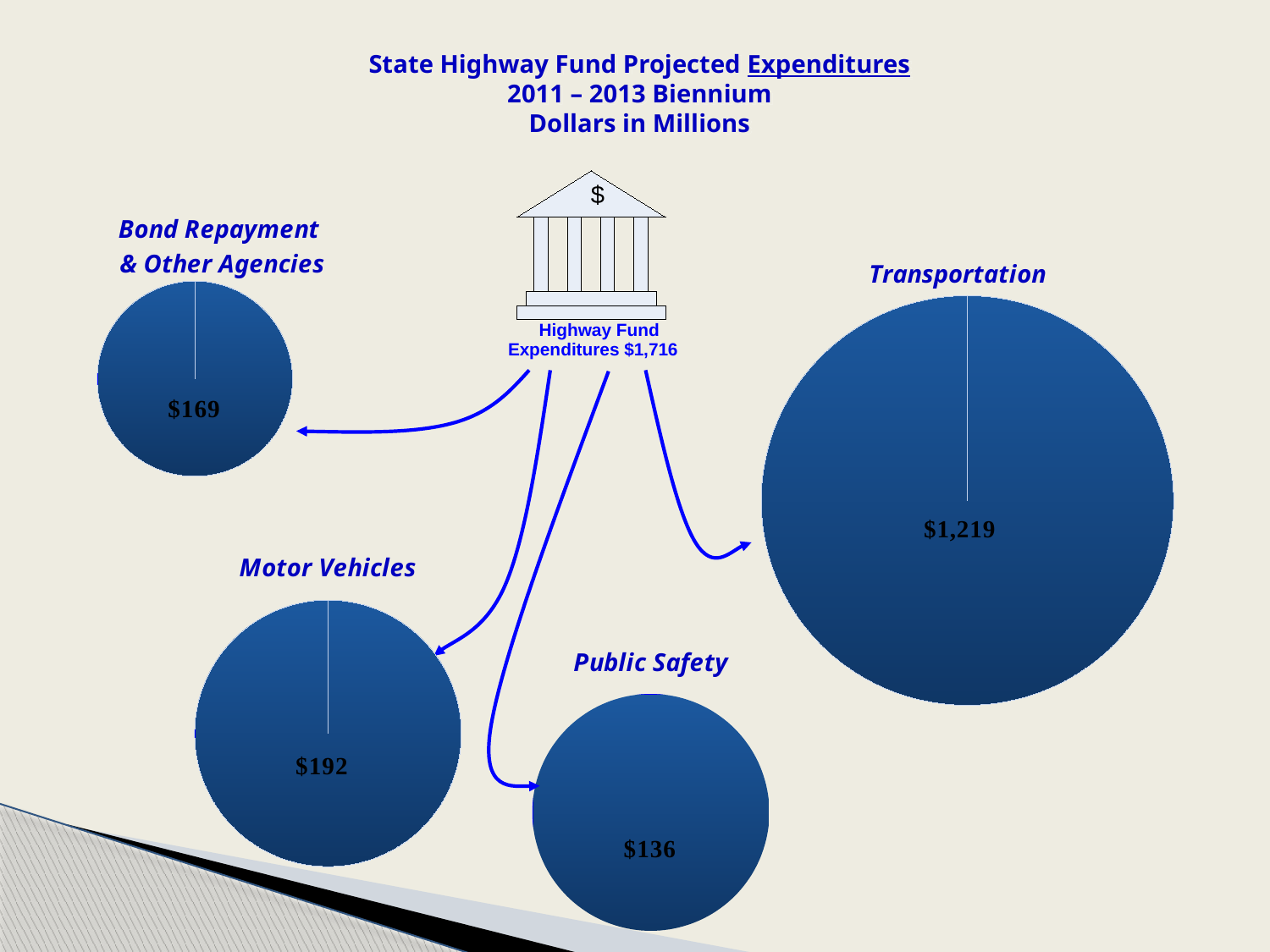
Which expenditure category has the largest value on the slide? Transportation Which is larger, the Motor Vehicles value or the Bond Repayment & Other Agencies value? Motor Vehicles What is the value shown in the Transportation circle? $1,219 What is the difference between the Transportation value and the Bond Repayment & Other Agencies value? $1,050 What is the value shown in the Motor Vehicles circle? $192 What is the difference between the Motor Vehicles value and the Public Safety value? $56 What is the total Highway Fund Expenditures figure shown on the slide? $1,716 How many expenditure categories are shown as circles on the slide? 4 Which expenditure category has the smallest value on the slide? Public Safety What is the value shown in the Bond Repayment & Other Agencies circle? $169 What is the value shown in the Public Safety circle? $136 In what units are the dollar values on the slide expressed, according to the title? Dollars in Millions